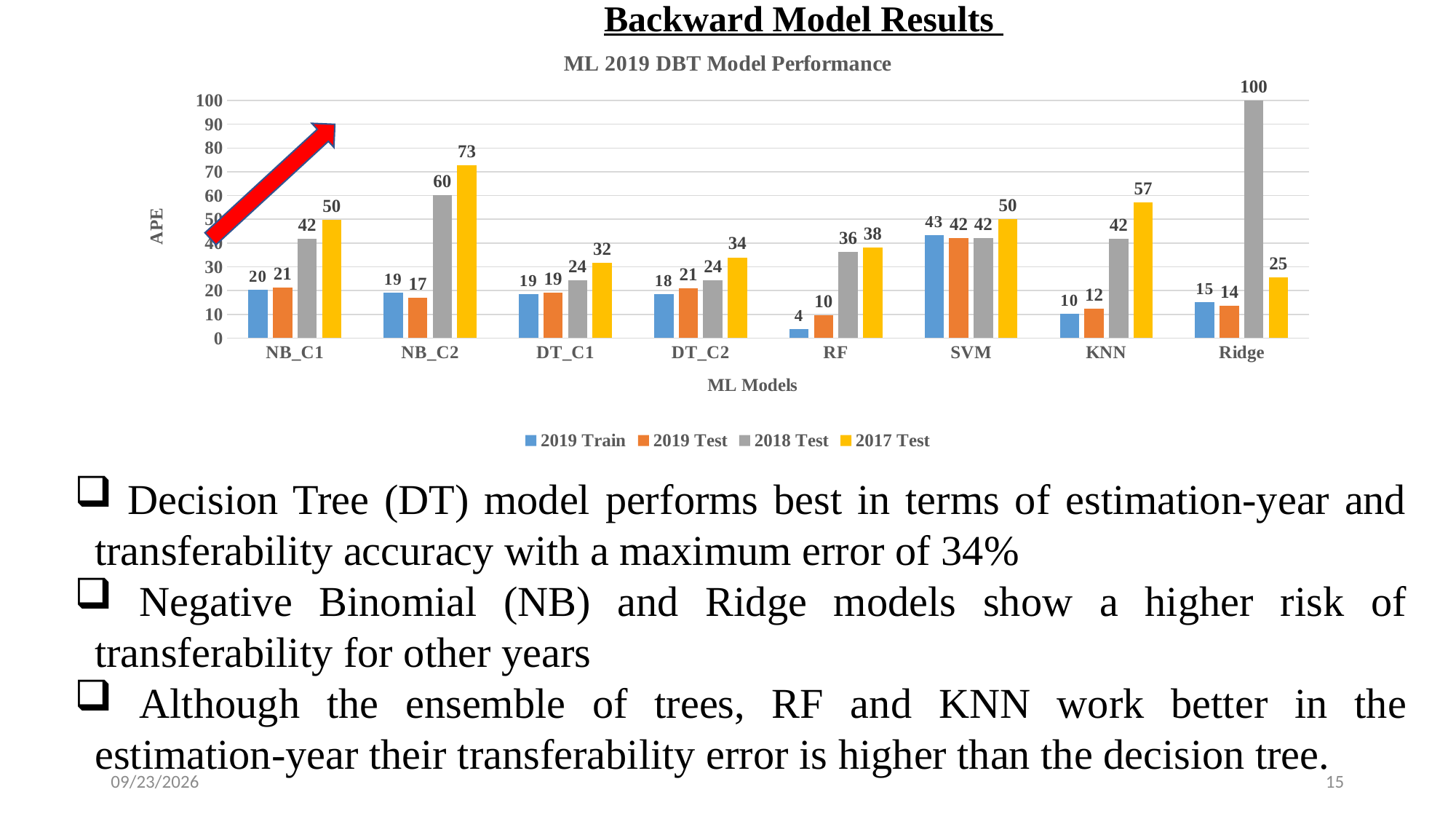
Which is larger, the 2018 Test APE for NB_C2 or the 2018 Test APE for DT_C2? NB_C2 How many series does the legend list? 4 Which ML model has the lowest 2017 Test APE value? Ridge What is the title of the chart? ML 2019 DBT Model Performance What is the 2018 Test APE value for Ridge? 100 What is the 2019 Test APE value for KNN? 12 Which ML model has the highest 2019 Train APE value? SVM How many ML models are shown on the x axis? 8 What is the 2017 Test APE value for NB_C2? 73 What is the 2019 Train APE value for RF? 4 What is the difference between the 2017 Test and 2019 Train APE values for KNN? 47 What kind of chart is shown on the slide? Bar chart